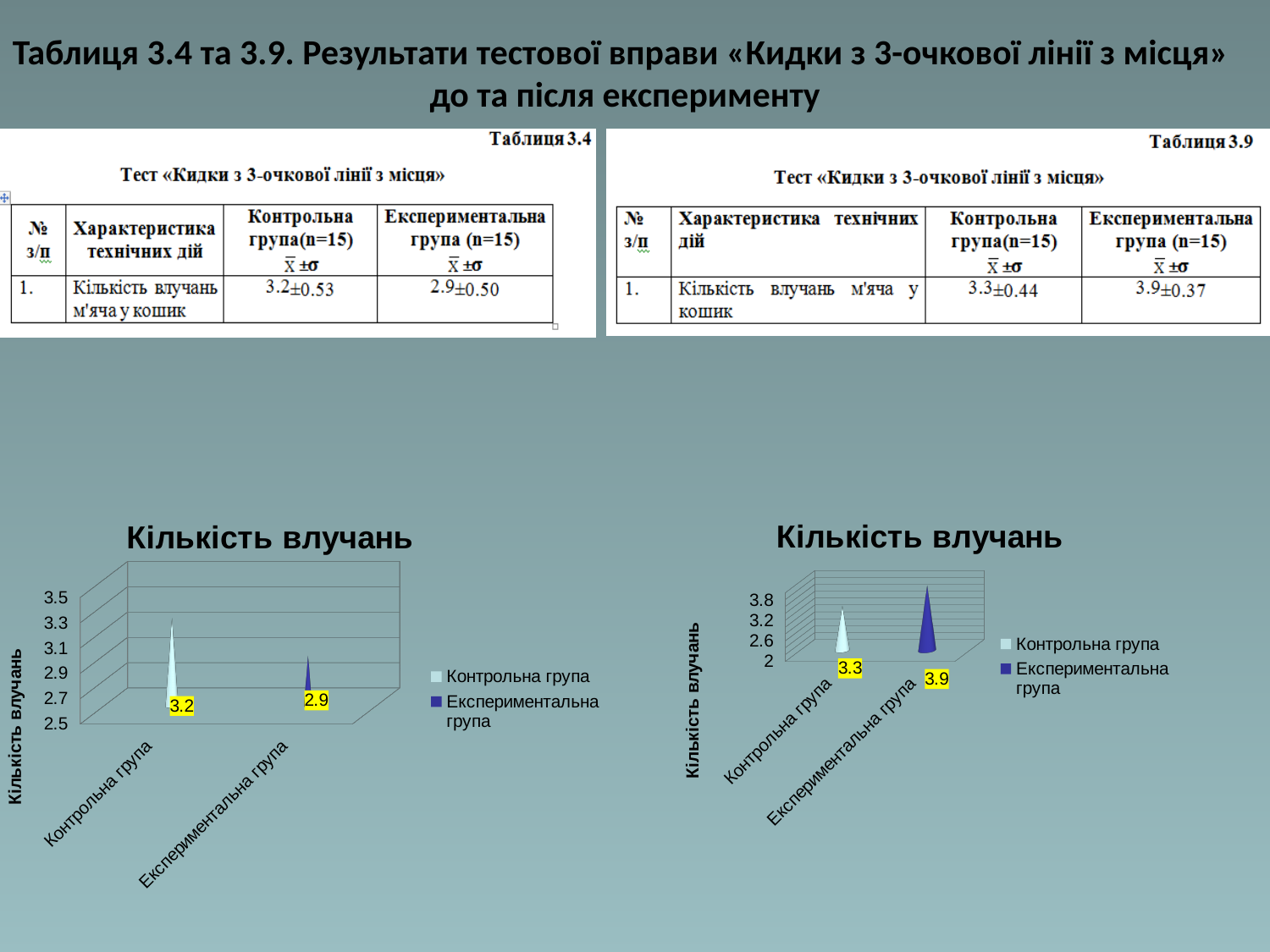
How many series does the legend of the left chart list? 2 In the right chart, which group has the lower value? Контрольна група In the right chart, what is the value for Експериментальна група? 3.9 In the left chart, what is the value for Контрольна група? 3.2 In the right chart, what is the difference between Експериментальна група and Контрольна група? 0.6 In the left chart, which group has the higher value? Контрольна група In the right chart, what is the value for Контрольна група? 3.3 In the left chart, what is the value for Експериментальна група? 2.9 What kind of chart is the right chart? bar chart In the right chart, is the value for Експериментальна група greater or less than 3.2? greater What is the title of the left chart? Кількість влучань In the left chart, what is the difference between Контрольна група and Експериментальна група? 0.3